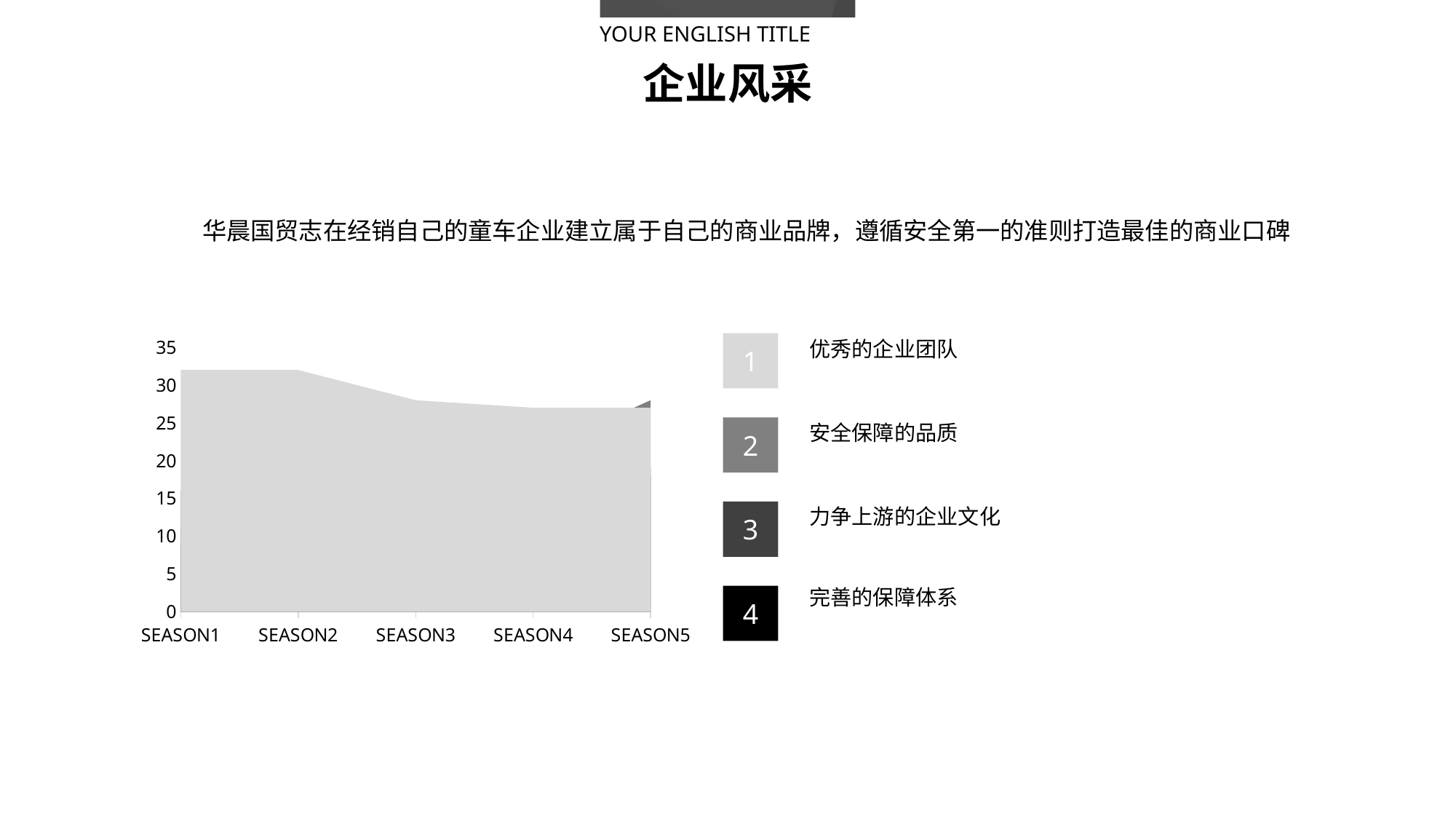
Which is larger, the value for SEASON1 or the value for SEASON4? SEASON1 What is the label of the first category on the x axis of the chart? SEASON1 What kind of chart is shown on the slide? area chart How many categories are plotted along the x axis of the chart? 5 Is the value for SEASON5 greater or less than 30? less What is the highest tick value shown on the y axis of the chart? 35 Is the value for SEASON3 greater or less than 30? less Do the values generally rise or fall from SEASON1 to SEASON5? fall Is the value for SEASON4 greater or less than 25? greater Which is larger, the value for SEASON2 or the value for SEASON3? SEASON2